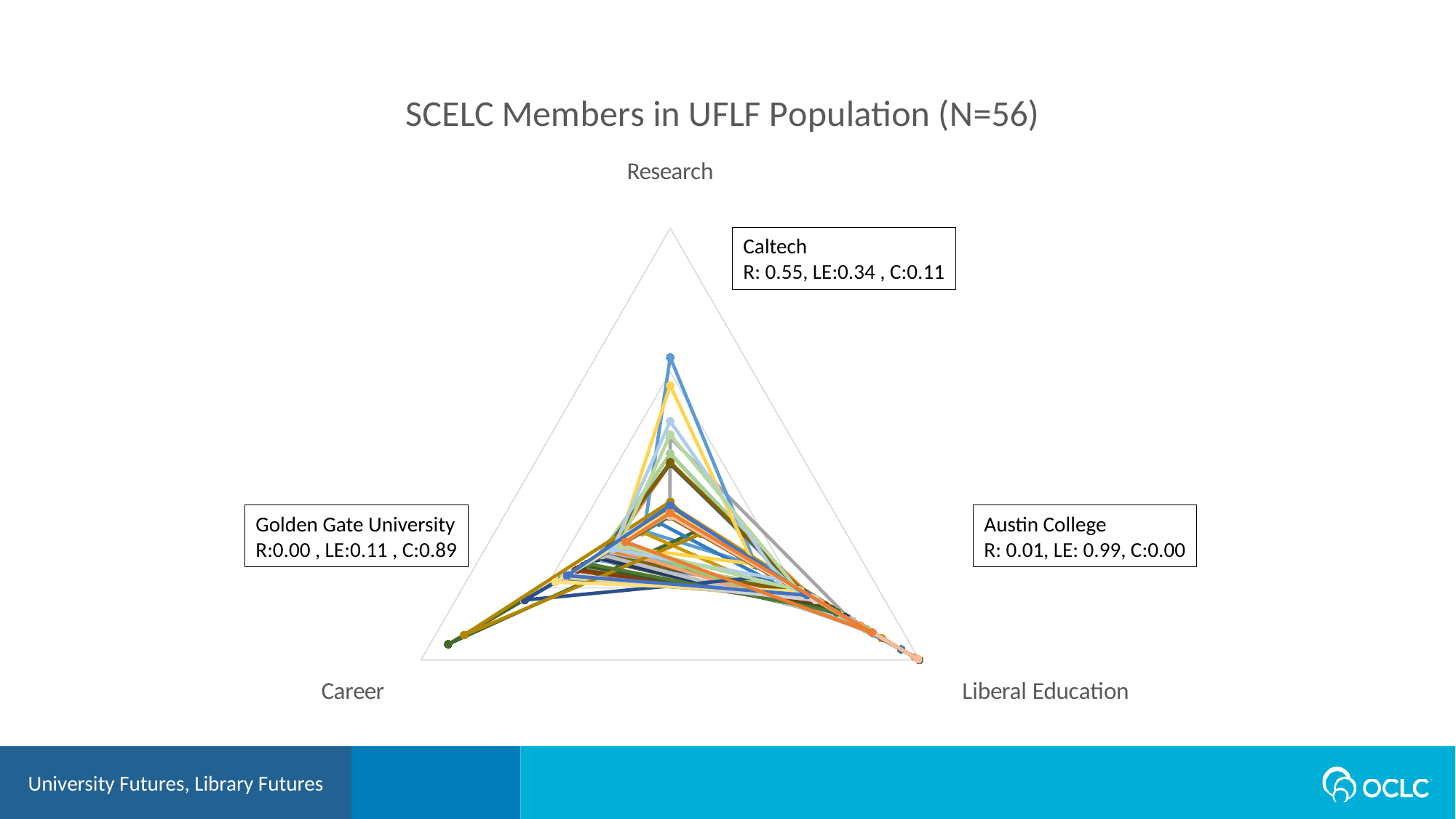
What is the Research (R) value annotated for Caltech? 0.55 Among the three annotated institutions, which has the highest Career value? Golden Gate University What is the Career (C) value annotated for Golden Gate University? 0.89 What is the difference between the annotated Liberal Education values of Austin College and Caltech? 0.65 What is the title of the chart? SCELC Members in UFLF Population (N=56) What kind of chart is shown on the slide? Radar chart Among the three annotated institutions, which has the lowest Liberal Education value? Golden Gate University Which has the higher annotated Research value, Caltech or Golden Gate University? Caltech How many axes (dimensions) does the radar chart have? 3 What is the Liberal Education (LE) value annotated for Austin College? 0.99 What is the Career (C) value annotated for Caltech? 0.11 What are the three axis labels on the radar chart? Research, Career, Liberal Education